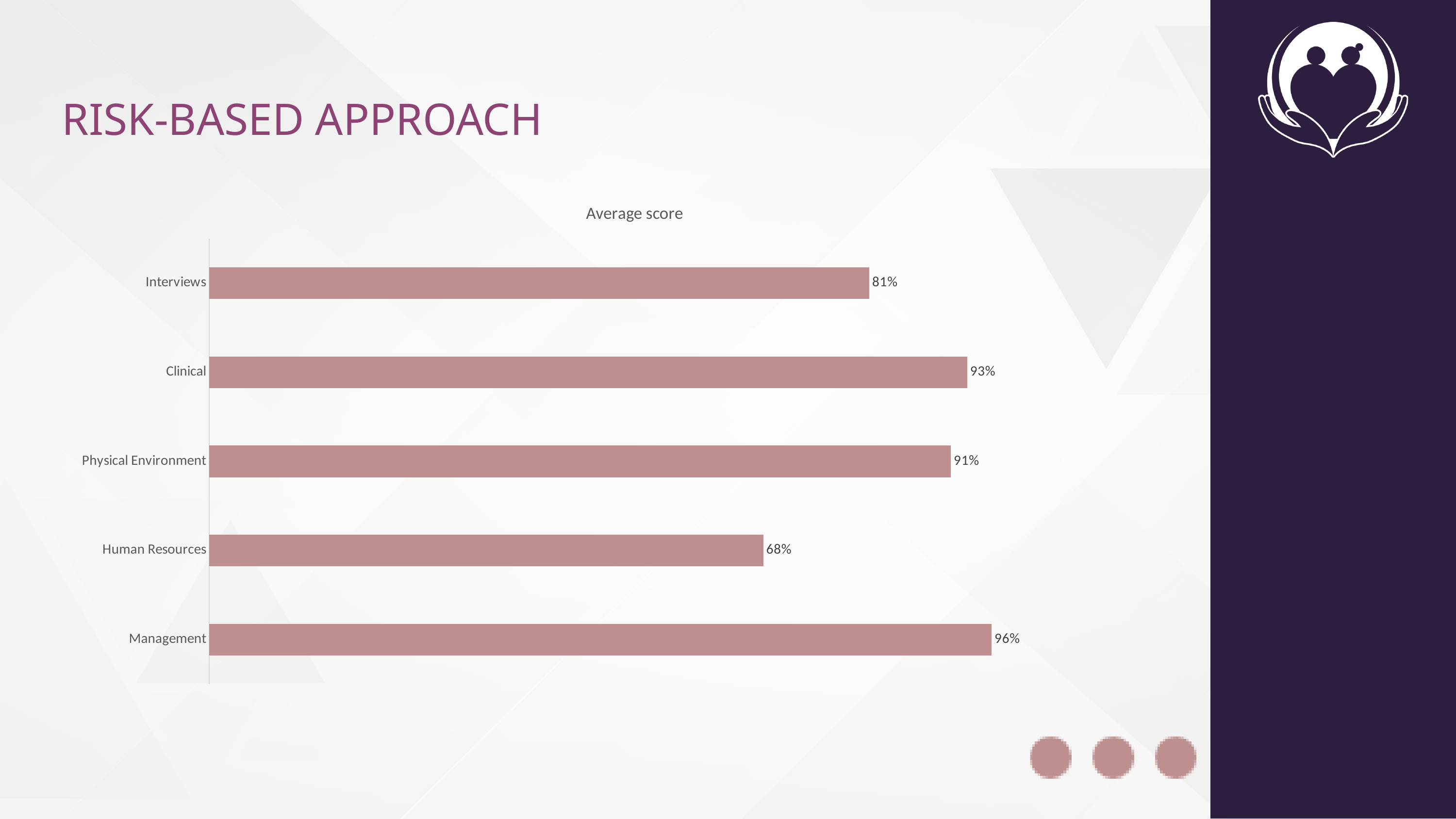
Which has a higher average score, Interviews or Physical Environment? Physical Environment What is the average score for Clinical? 93% What is the average score for Management? 96% What is the title of the chart? Average score What is the difference between the average scores for Management and Human Resources? 28% Which category has the lowest average score? Human Resources How many categories are shown in the chart? 5 What is the difference between the average scores for Clinical and Physical Environment? 2% Which category has the highest average score? Management What is the average score for Interviews? 81% What kind of chart is shown on the slide? Bar chart What is the average score for Human Resources? 68%